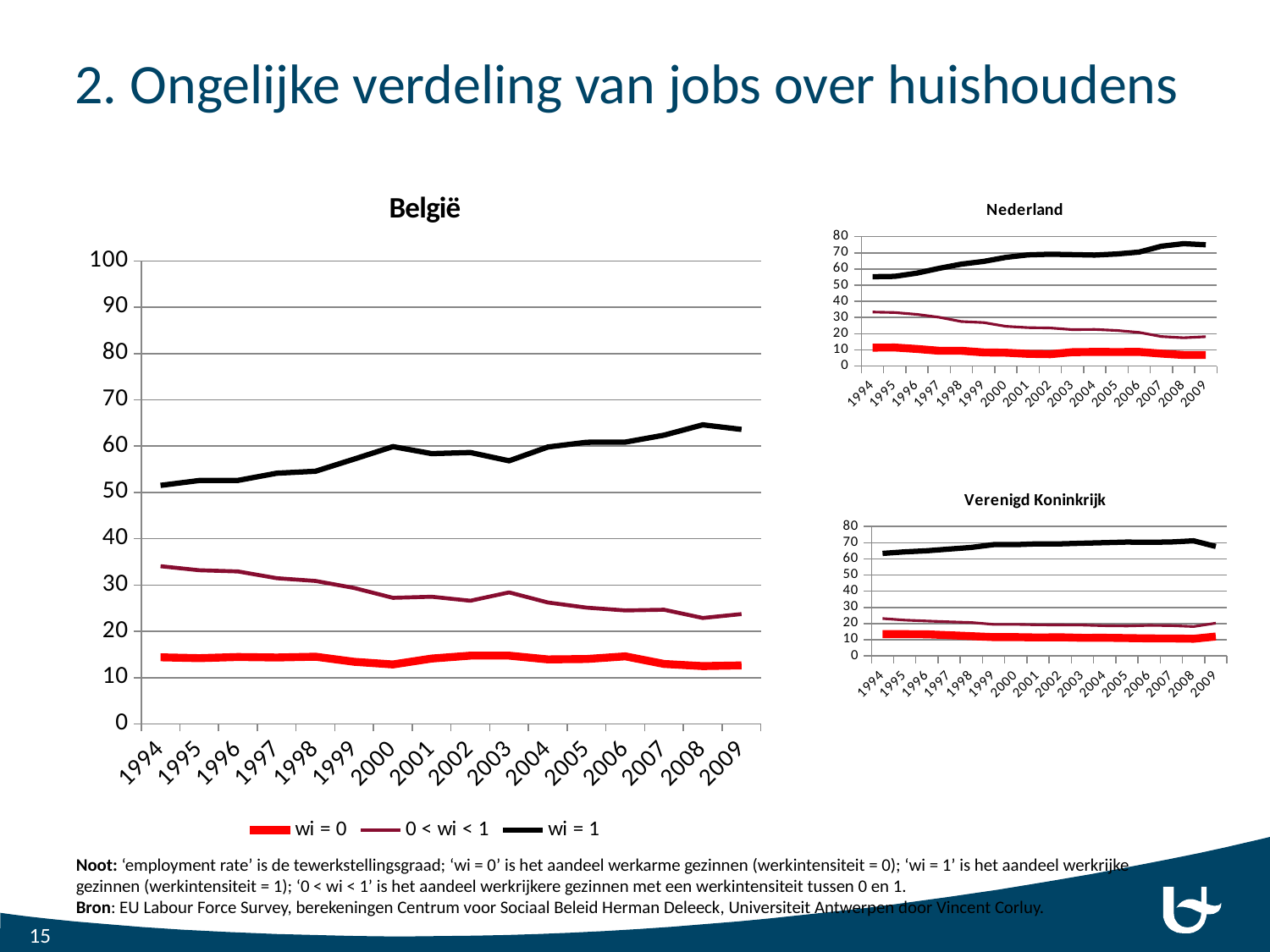
In the 'België' chart, which series has the lowest values across all years? wi = 0 How many series does the legend of the 'België' chart list? 3 In the 'België' chart, is the value for 'wi = 0' in 1994 greater or less than 20? less In the 'België' chart, does the '0 < wi < 1' series generally rise or fall from 1994 to 2009? fall In the 'België' chart, which series has the highest values across all years? wi = 1 What is the title of the small chart at the top right of the slide? Nederland In the 'Verenigd Koninkrijk' chart, is the value for '0 < wi < 1' in 1994 greater or less than 30? less How many years are shown on the x axis of the 'België' chart? 16 What kind of chart is the 'België' chart? line chart In the 'België' chart, is the value for 'wi = 1' in 2009 greater or less than 60? greater In the 'België' chart, does the 'wi = 1' series generally rise or fall from 1994 to 2009? rise